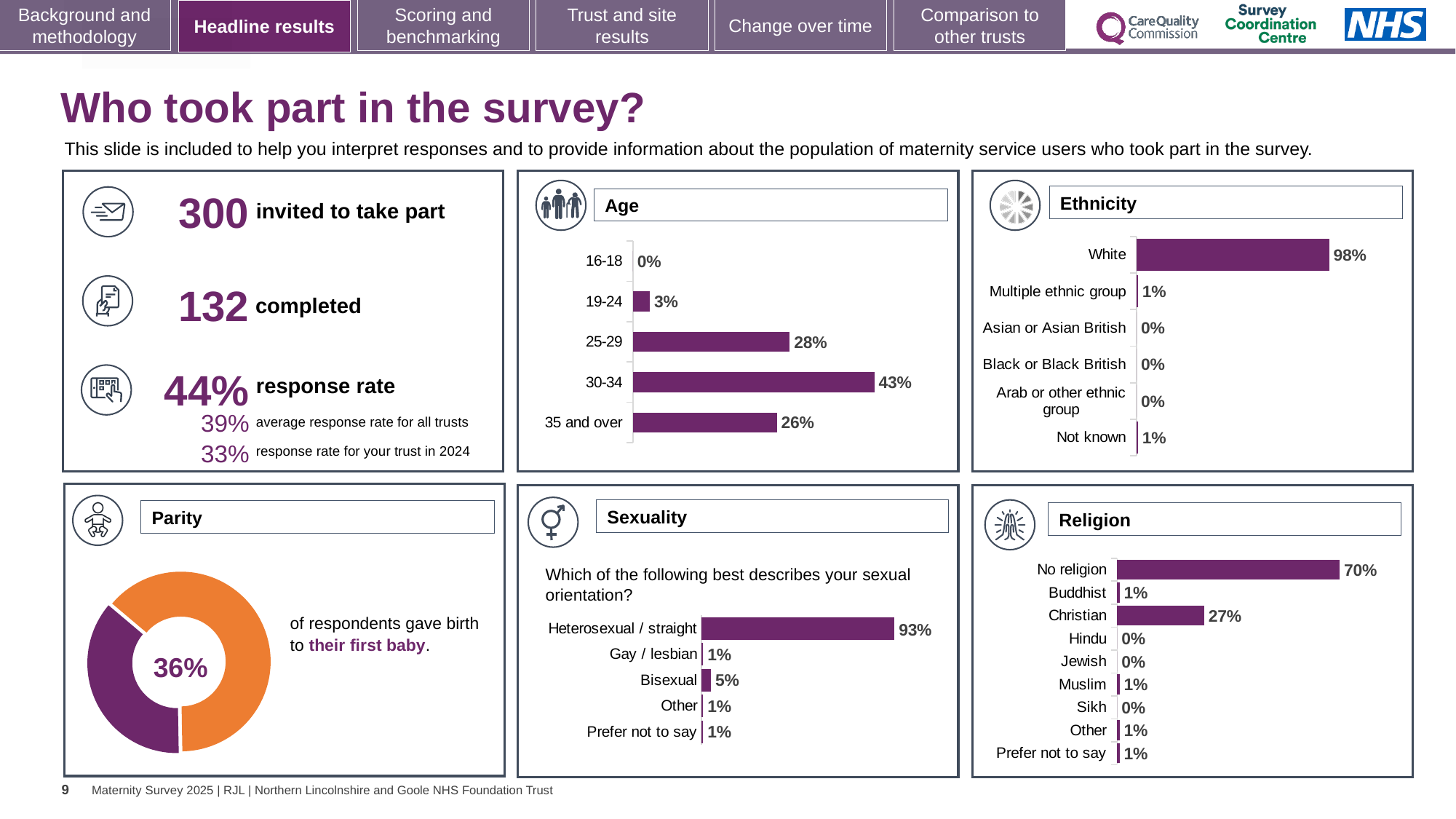
In the Age chart, how many age categories are shown? 5 In the Sexuality chart, which is larger, Bisexual or Gay / lesbian? Bisexual In the Sexuality chart, what percentage of respondents answered Bisexual? 5% In the Ethnicity chart, what percentage of respondents were White? 98% In the Religion chart, what percentage of respondents were Christian? 27% In the Age chart, what is the difference between the 30-34 and 25-29 percentages? 15% In the Age chart, which age group has the highest percentage? 30-34 In the Parity chart, what share of respondents gave birth to their first baby? 36% In the Age chart, what percentage of respondents were aged 30-34? 43% In the Religion chart, what is the difference between No religion and Christian? 43% In the Ethnicity chart, what percentage is shown for Not known? 1% In the Religion chart, which category has the highest percentage? No religion